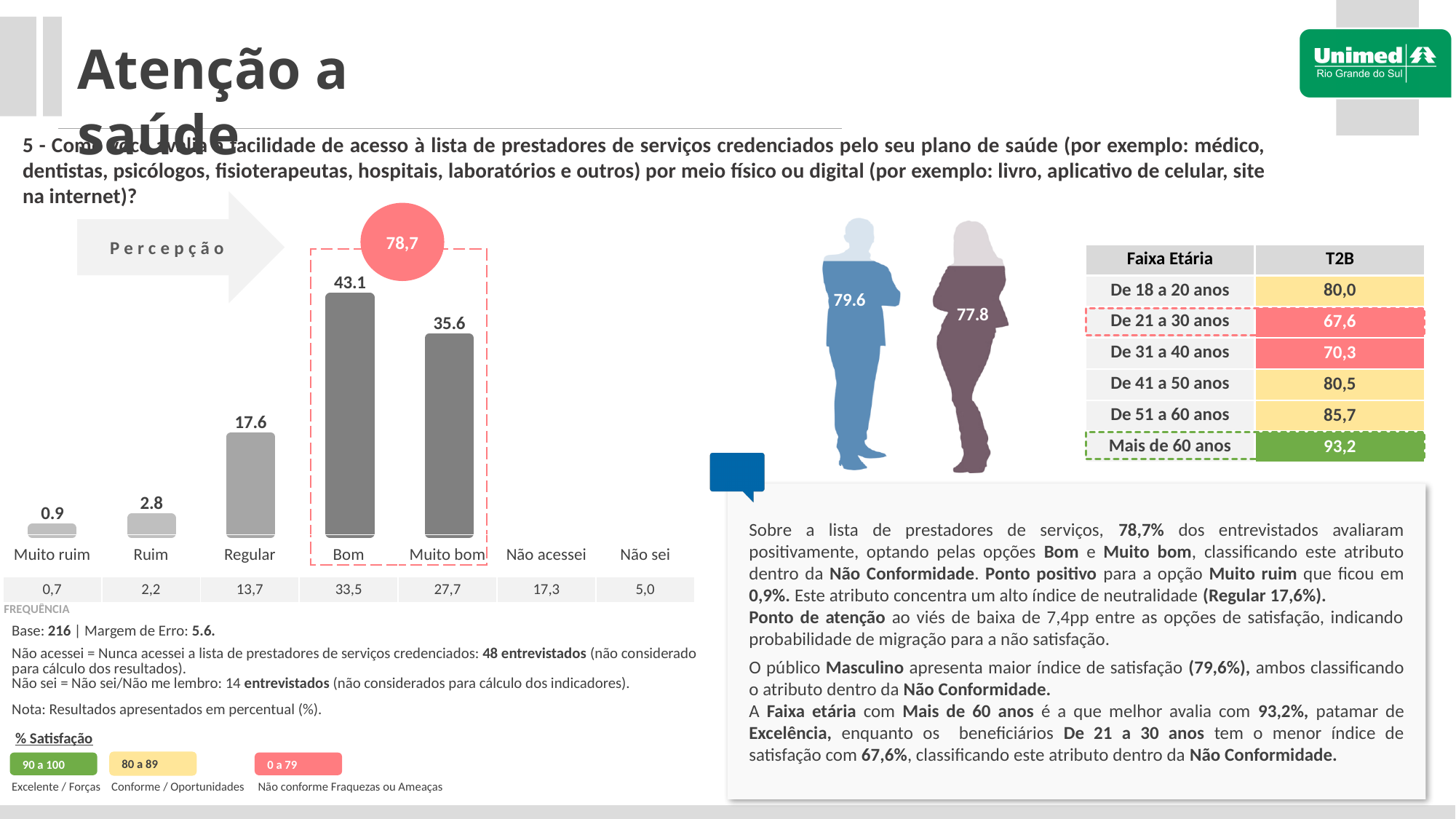
What is the value shown for the Bom bar? 43.1 How many bars are plotted in the chart? 5 Which category has the lowest bar in the chart? Muito ruim What value is shown in the red circle above the Bom and Muito bom bars? 78,7 Which is larger, the value for Regular or the value for Ruim? Regular What kind of chart is used to show the Percepção results? Bar chart What is the value shown for the Regular bar? 17.6 Which category has the highest bar in the chart? Bom What is the difference between the Regular and Ruim values? 14.8 What is the value shown for the Muito bom bar? 35.6 What is the difference between the Bom and Muito bom values? 7.5 What is the value shown for the Muito ruim bar? 0.9